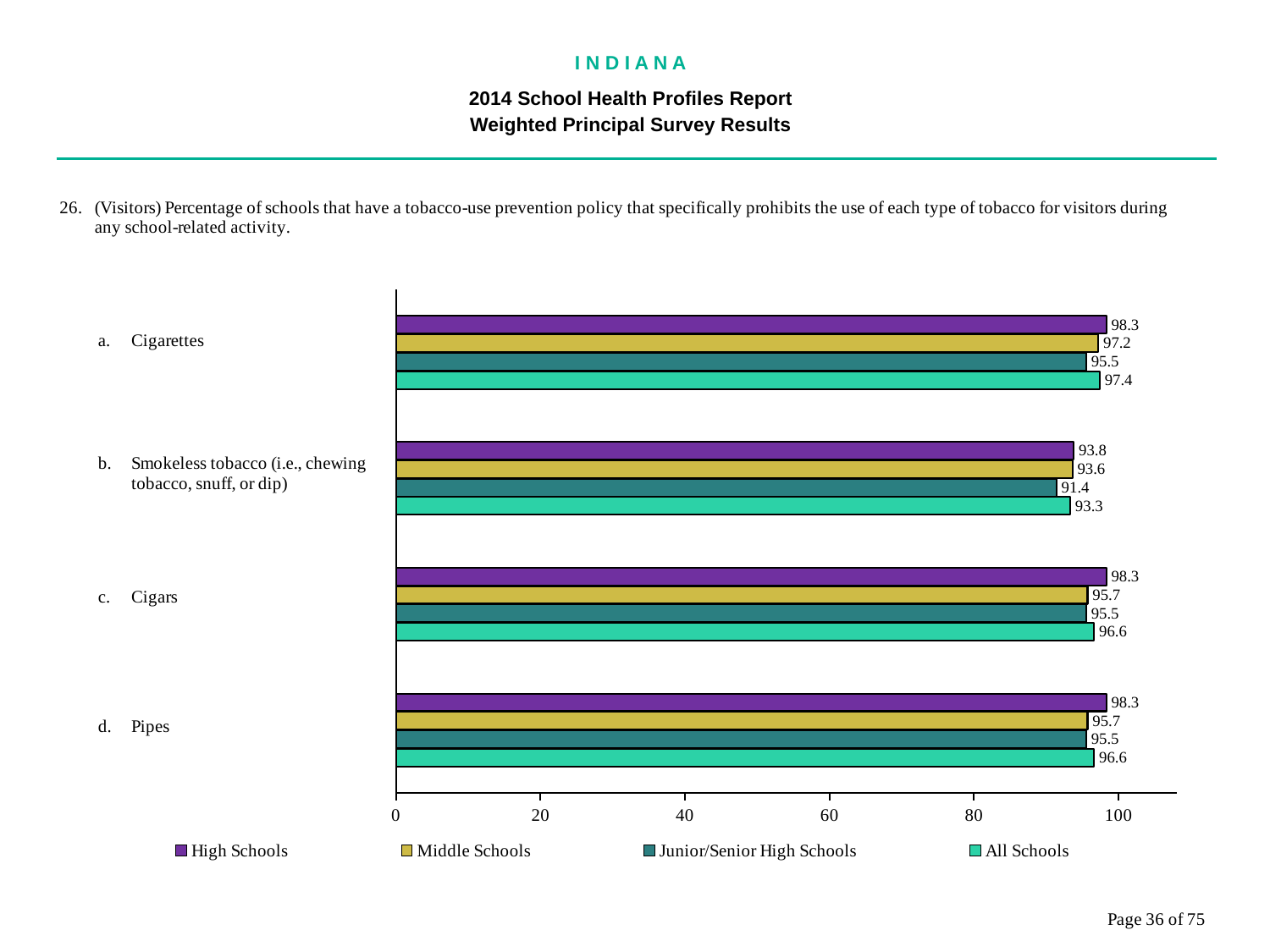
What is the value for High Schools for Cigarettes? 98.3 What is the difference between the High Schools and Middle Schools values for Cigars? 2.6 What is the difference between the All Schools values for Cigarettes and Smokeless tobacco? 4.1 How many categories are shown on the chart? 4 Which is larger: the Middle Schools value for Cigarettes or the Middle Schools value for Smokeless tobacco? Cigarettes How many series does the legend list? 4 Which category has the lowest value for All Schools? Smokeless tobacco What is the value for Junior/Senior High Schools for Smokeless tobacco? 91.4 What kind of chart is shown on the slide? Bar chart What is the value for Middle Schools for Pipes? 95.7 Which series has the lowest value for Cigarettes? Junior/Senior High Schools What is the value for All Schools for Cigars? 96.6